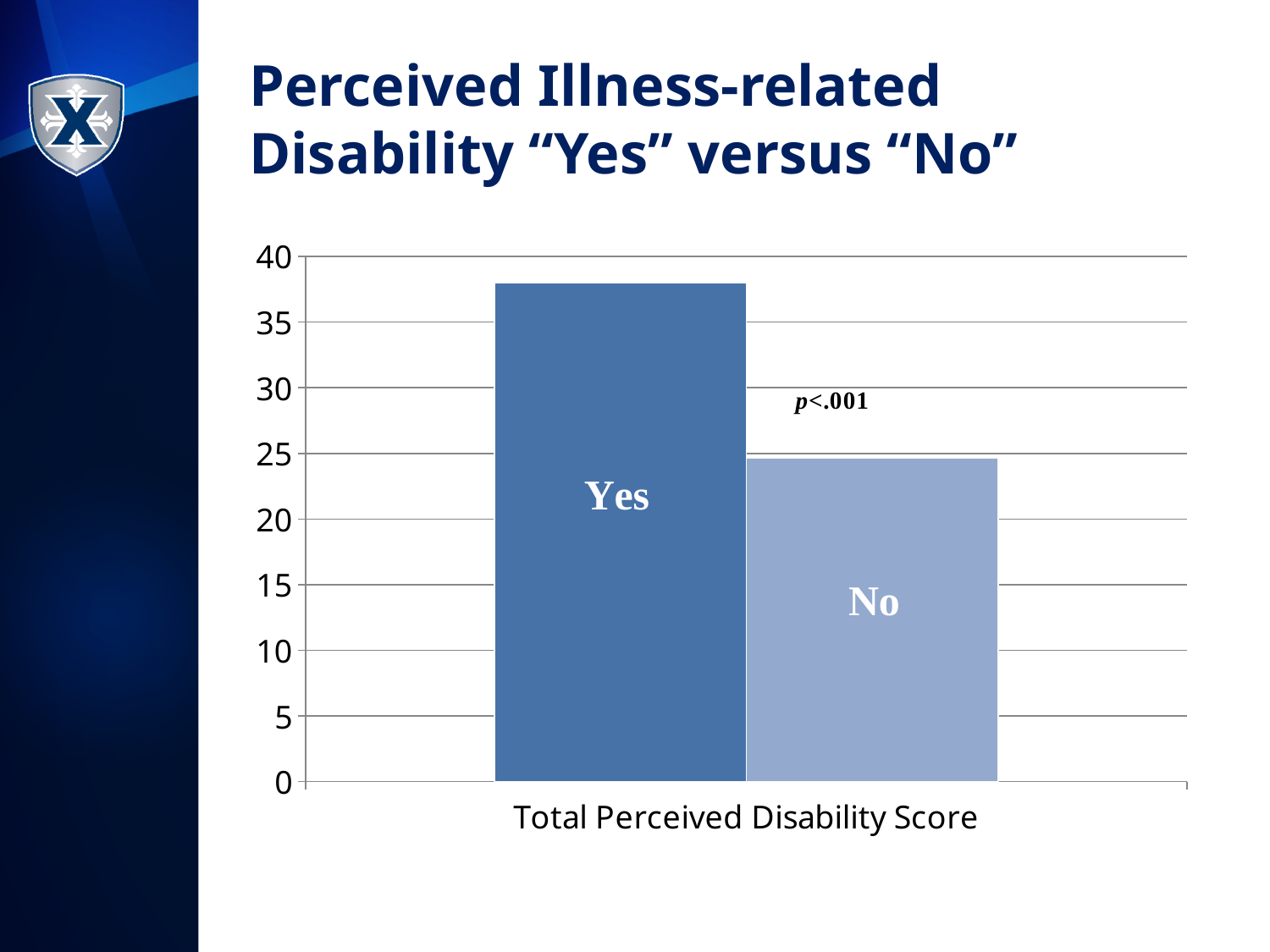
Is the value for "Yes" greater or less than 40? less How many bars are plotted in the chart? 2 Is the value for "No" greater or less than 20? greater Is the value for "Yes" greater or less than 35? greater What is the label shown beneath the bars on the horizontal axis? Total Perceived Disability Score Which bar is lowest in the chart? No What p-value annotation is printed on the chart? p<.001 Which bar is highest, "Yes" or "No"? Yes What kind of chart is shown on the slide? bar chart Is the value for "Yes" larger or smaller than the value for "No"? larger